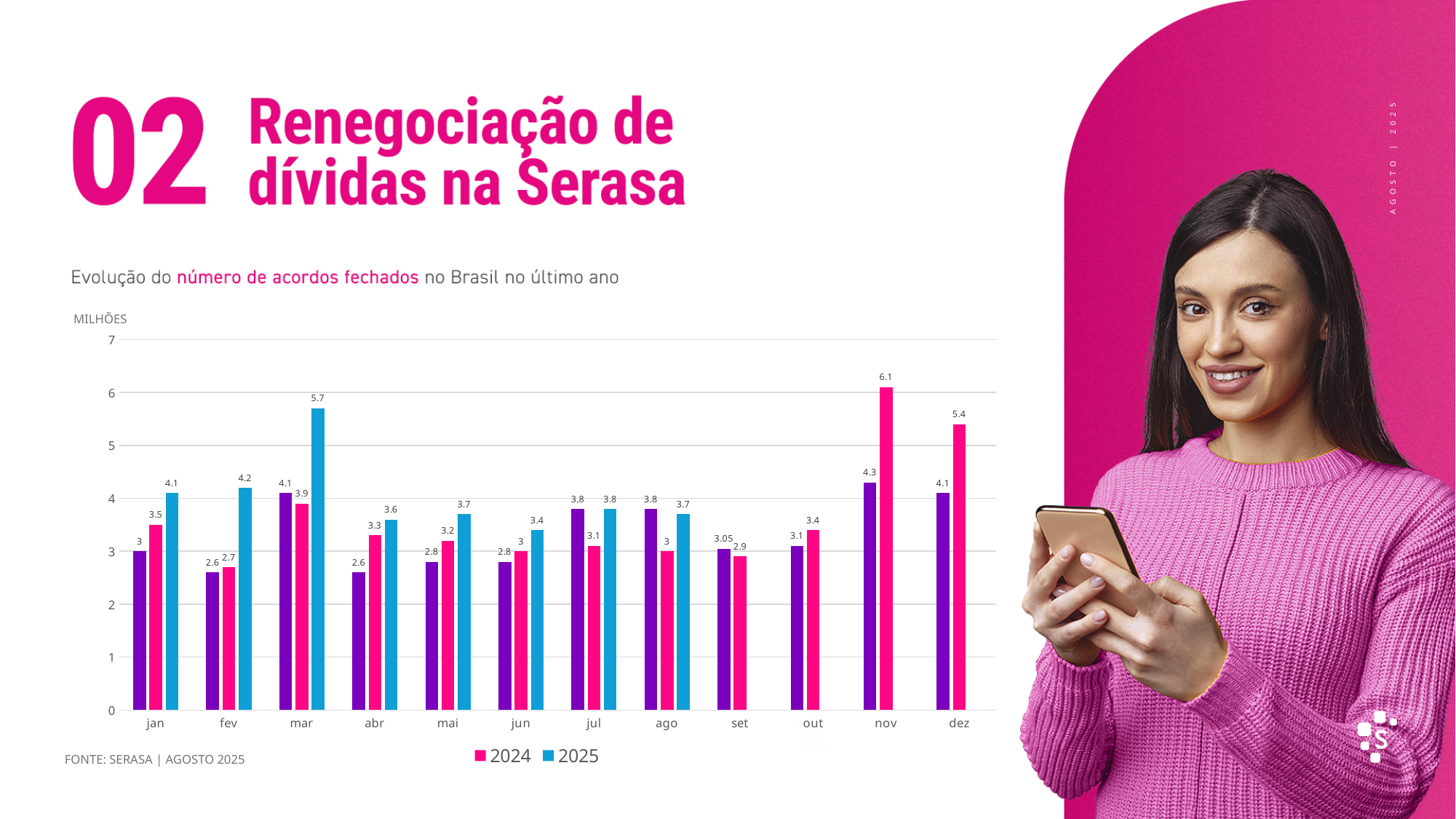
For jul, which is larger: the 2024 value or the 2025 value? 2025 What is the difference between the 2025 and 2024 values for fev? 1.5 What is the 2024 value for dez? 5.4 How many months are shown on the x axis? 12 What is the 2024 value for nov? 6.1 Which month has the highest 2025 value? mar What kind of chart is shown? bar chart Which month has the lowest 2024 value? fev Is the 2024 value for nov greater or less than 5? greater What is the 2025 value for mar? 5.7 How many series does the legend list? 2 Which month has the highest 2024 value? nov